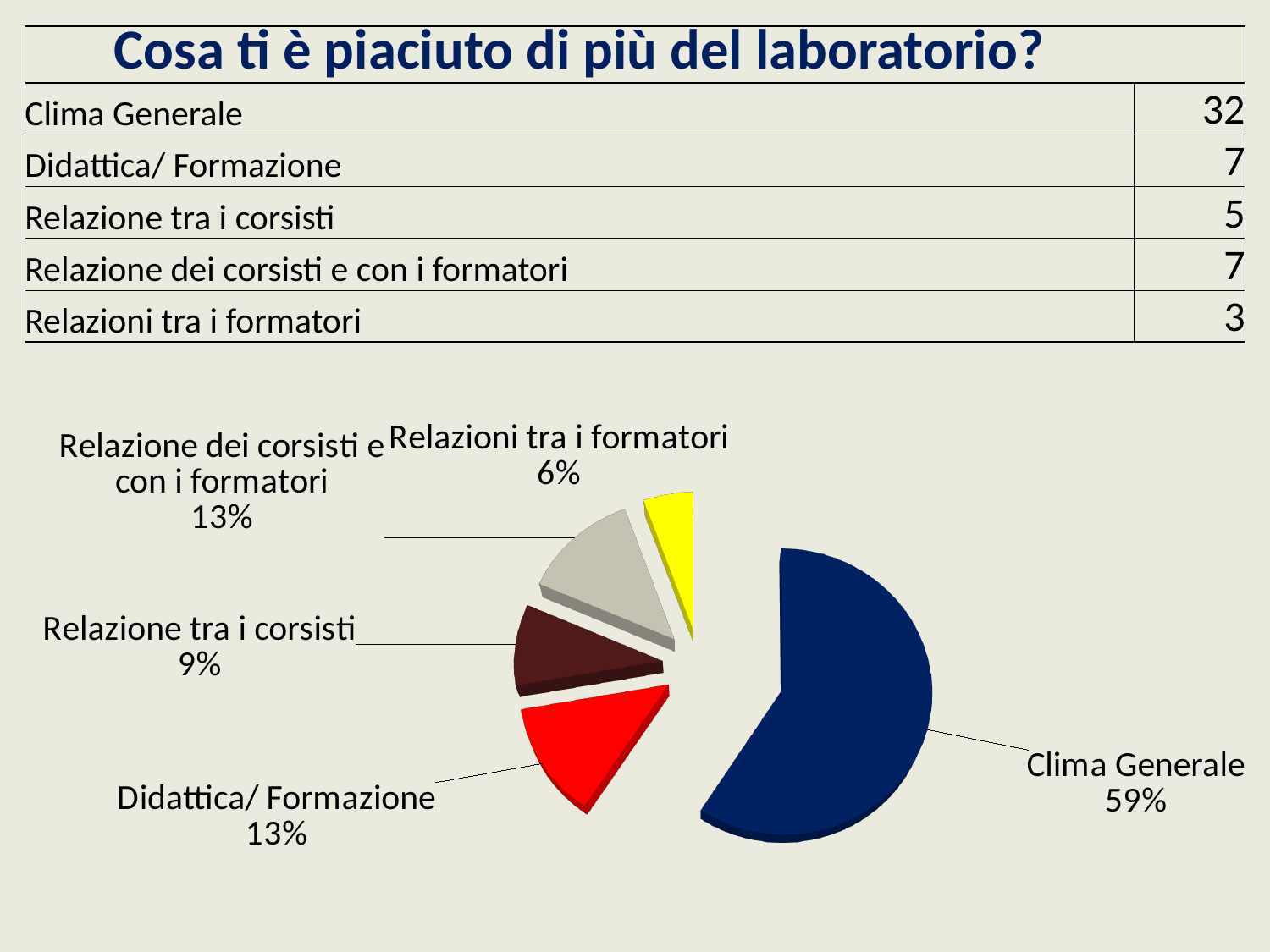
Which category has the largest slice of the pie? Clima Generale What share of the pie does Didattica/ Formazione have? 13% What colour is the Clima Generale slice? dark blue What share of the pie does Relazioni tra i formatori have? 6% What is the difference in percentage points between the Clima Generale slice and the Didattica/ Formazione slice? 46 What share of the pie does Relazione tra i corsisti have? 9% Which is larger, the slice for Relazione tra i corsisti or the slice for Relazioni tra i formatori? Relazione tra i corsisti How many slices does the pie chart have? 5 What kind of chart is shown on the slide? pie chart What is the title shown above the table on the slide? Cosa ti è piaciuto di più del laboratorio? Which category has the smallest slice of the pie? Relazioni tra i formatori